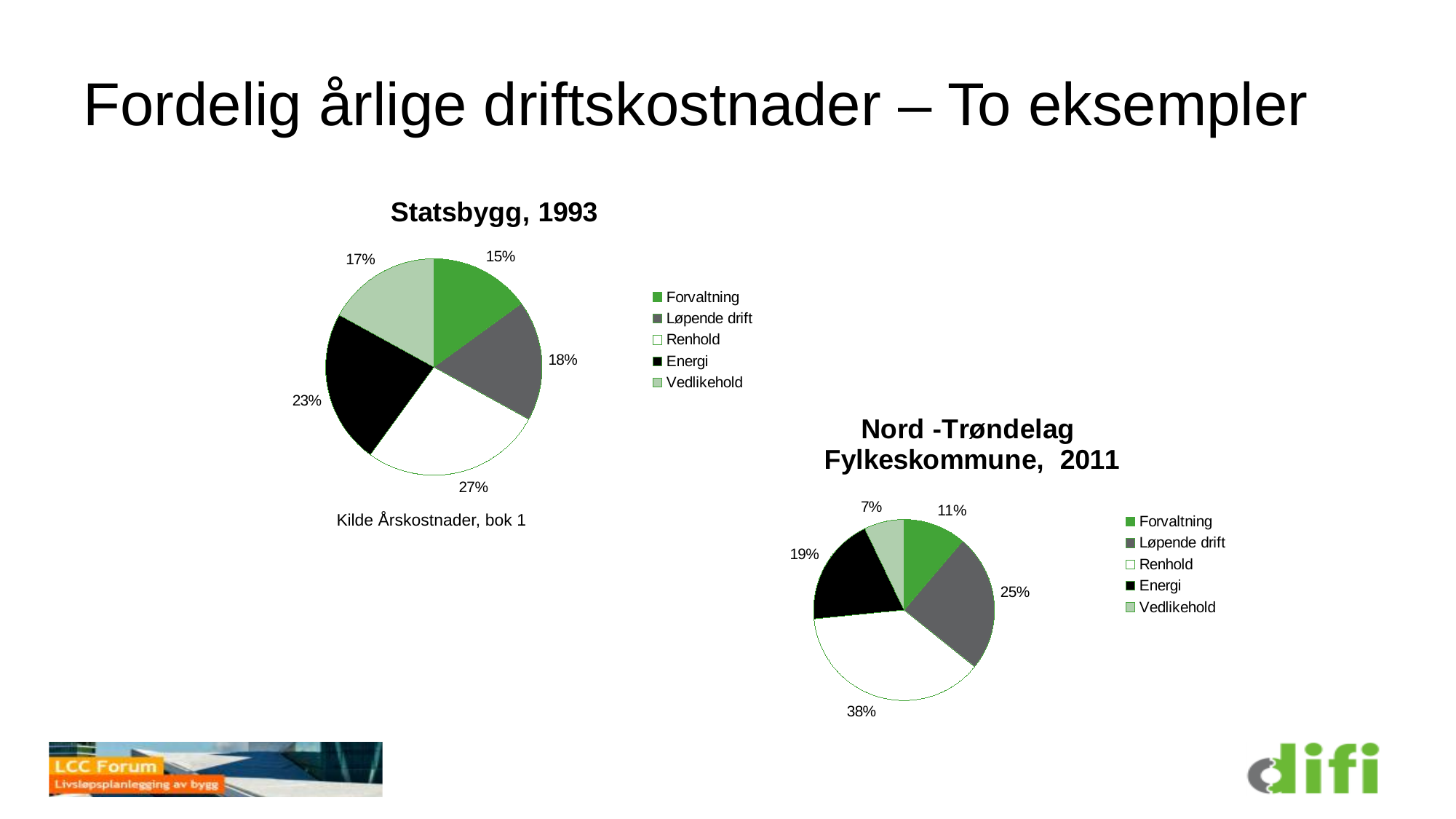
How many categories does the "Nord -Trøndelag Fylkeskommune, 2011" chart show? 5 In the "Statsbygg, 1993" chart, which is larger, the share for Energi or the share for Løpende drift? Energi In the "Nord -Trøndelag Fylkeskommune, 2011" chart, what is the difference between the Renhold share and the Energi share? 19% In the "Statsbygg, 1993" chart, which category has the smallest share? Forvaltning In the "Nord -Trøndelag Fylkeskommune, 2011" chart, what share does Løpende drift have? 25% In the "Statsbygg, 1993" chart, what share does Energi have? 23% In the "Statsbygg, 1993" chart, what share does Renhold have? 27% In the "Statsbygg, 1993" chart, which colour represents Energi in the legend? Black In the "Statsbygg, 1993" chart, which category has the largest share? Renhold What kind of chart is the "Statsbygg, 1993" chart? Pie chart In the "Nord -Trøndelag Fylkeskommune, 2011" chart, what share does Vedlikehold have? 7% In the "Nord -Trøndelag Fylkeskommune, 2011" chart, which category has the smallest share? Vedlikehold